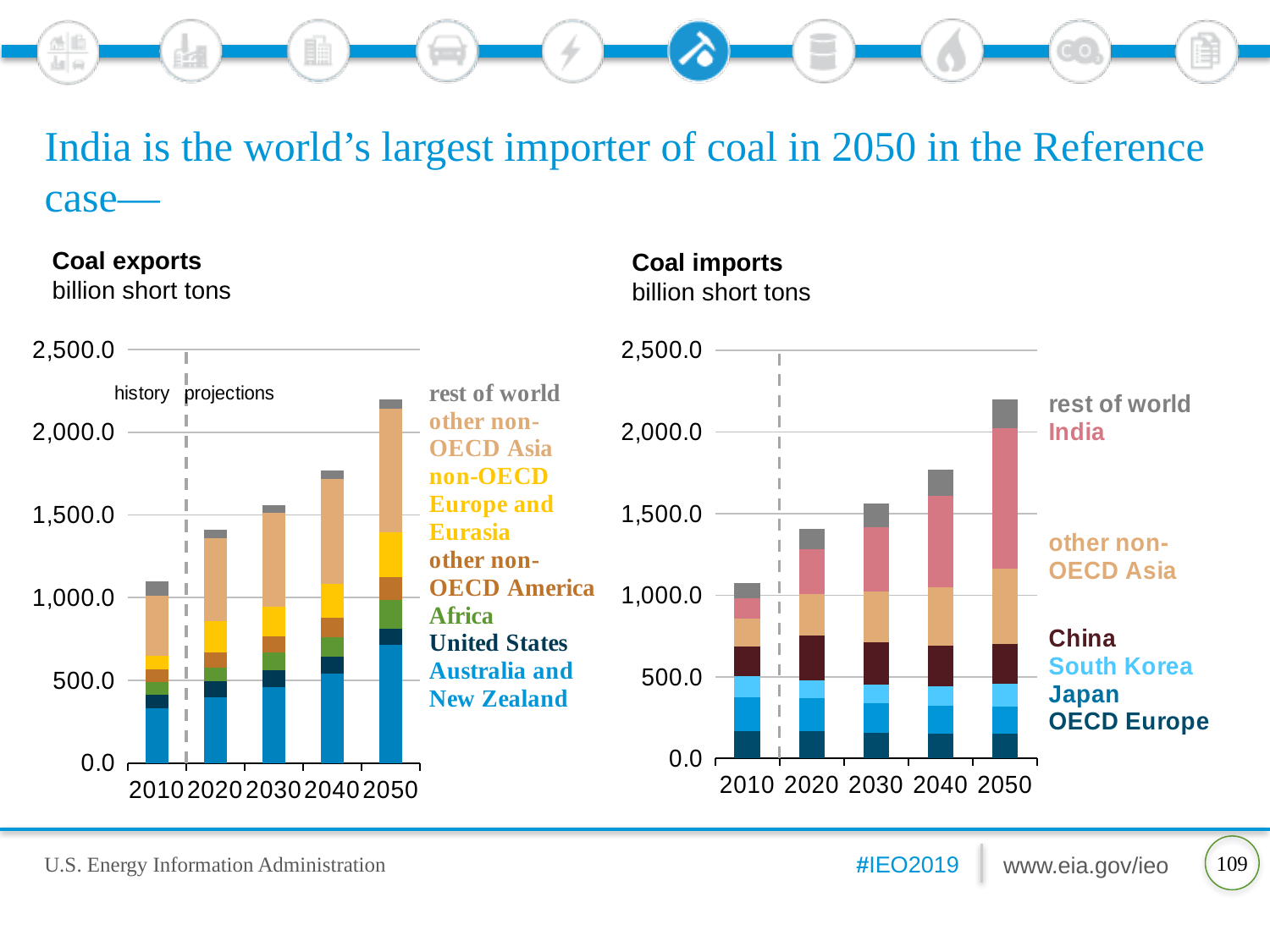
What kind of chart is the Coal exports chart? stacked bar chart In the Coal imports chart, which year has the tallest total bar? 2050 In the Coal exports chart, which year has the shortest total bar? 2010 What unit is used on the y axis of both charts? billion short tons In the Coal imports chart, is the total for 2050 greater or less than 2,000? greater In the Coal exports chart, is the total for 2020 greater or less than 1,500? less In the Coal exports chart, do total exports rise or fall from 2010 to 2050? rise In the Coal imports chart, is the total for 2040 greater or less than 2,000? less In the Coal imports chart, which total bar is larger, 2010 or 2050? 2050 How many series does the legend of the Coal imports chart list? 7 How many series does the legend of the Coal exports chart list? 7 How many years are shown on the x axis of the Coal imports chart? 5